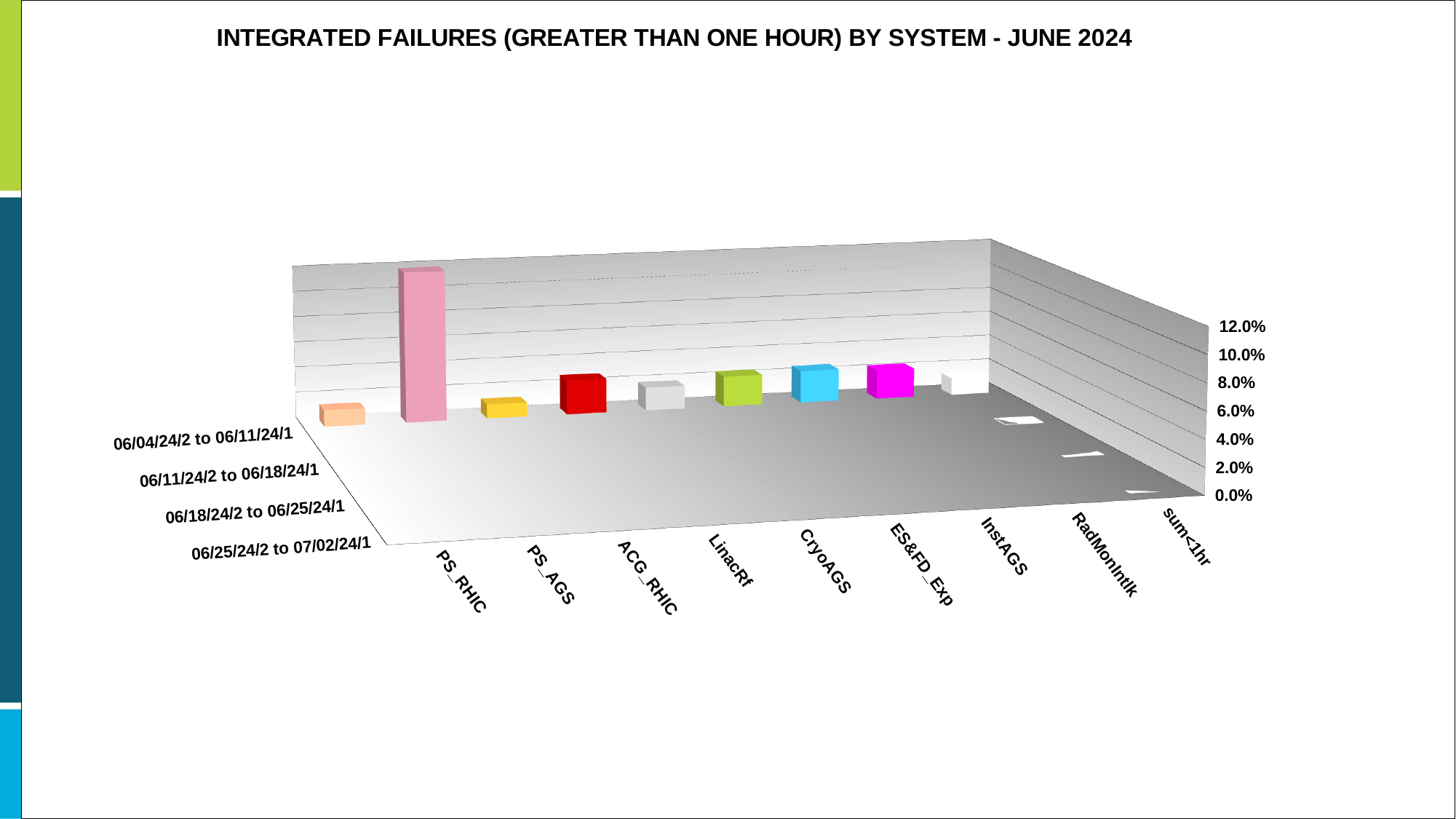
Which bar is taller, PS_AGS or LinacRf? PS_AGS Which date range is listed first (at the back) on the depth axis? 06/04/24/2 to 06/11/24/1 Is the tallest bar (PS_AGS) greater or less than 8.0%? greater What is the highest value shown on the percentage axis? 12.0% Is the value for PS_AGS greater or less than 6.0%? greater How many date ranges are listed along the depth axis of the chart? 4 Which system has the tallest bar in the chart? PS_AGS How many systems are listed along the category axis of the chart? 9 What is the title of the chart? INTEGRATED FAILURES (GREATER THAN ONE HOUR) BY SYSTEM - JUNE 2024 Which bar is taller, PS_AGS or PS_RHIC? PS_AGS Which bar is taller, LinacRf or ACG_RHIC? LinacRf What kind of chart is shown on the slide? bar chart